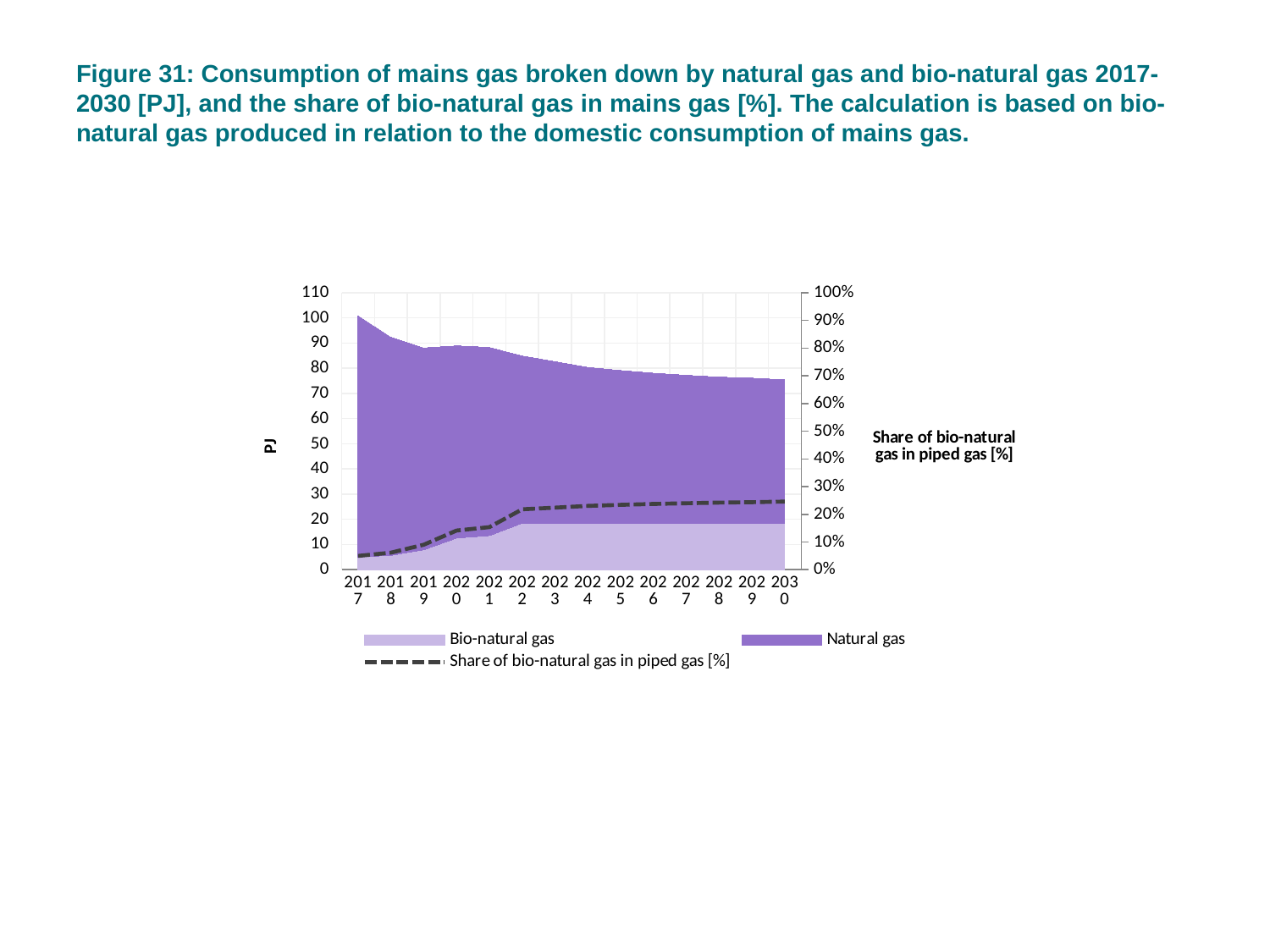
What kind of chart is shown on the slide? combination area and line chart How many series does the legend list? 3 Is the total mains gas consumption in 2017 greater or less than 90 PJ? greater What is the label of the left vertical axis? PJ Which series is plotted as a dashed line? Share of bio-natural gas in piped gas [%] Does the total mains gas consumption rise or fall from 2017 to 2030? fall Is the share of bio-natural gas in piped gas in 2017 greater or less than 10%? less In which year is the total mains gas consumption highest? 2017 Is the bio-natural gas consumption in 2030 greater or less than 10 PJ? greater Does the share of bio-natural gas in piped gas rise or fall from 2017 to 2030? rise How many years are shown on the x axis? 14